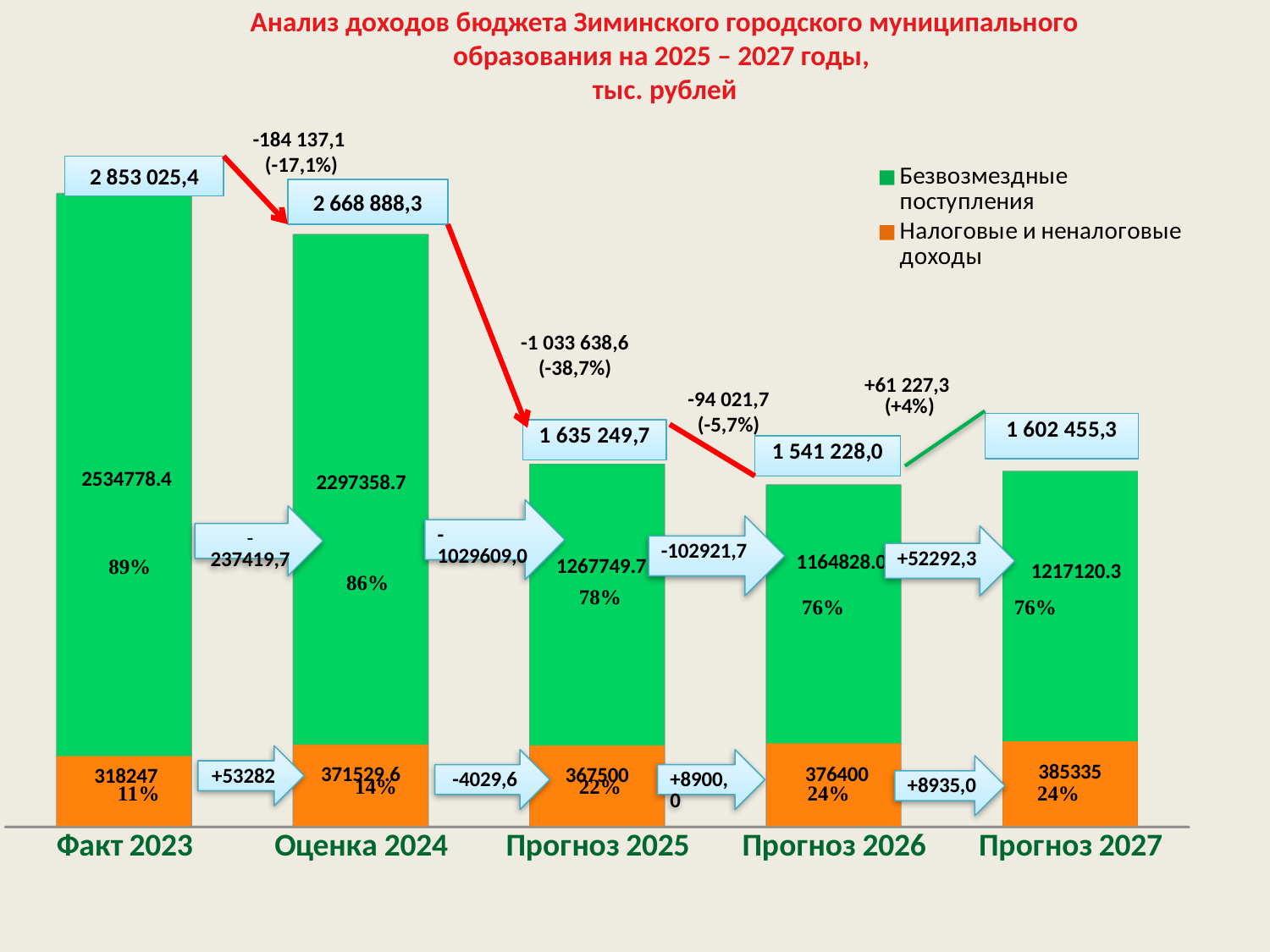
What is the value of Безвозмездные поступления for Факт 2023? 2534778.4 What is the percentage change in total income from Оценка 2024 to Прогноз 2025, as labelled on the slide? -38,7% Which year has the highest total budget income? Факт 2023 What type of chart is shown on the slide? stacked bar chart What is the value of Налоговые и неналоговые доходы for Прогноз 2027? 385335 How many categories (years) are shown along the x axis? 5 Which year has the lowest total budget income? Прогноз 2026 What is the total budget income shown for Оценка 2024? 2 668 888,3 What share of the total does Безвозмездные поступления make up in Прогноз 2026? 76% What is the total budget income shown for Прогноз 2025? 1 635 249,7 How many series does the legend list? 2 Which is larger: Налоговые и неналоговые доходы for Оценка 2024 or for Прогноз 2025? Оценка 2024